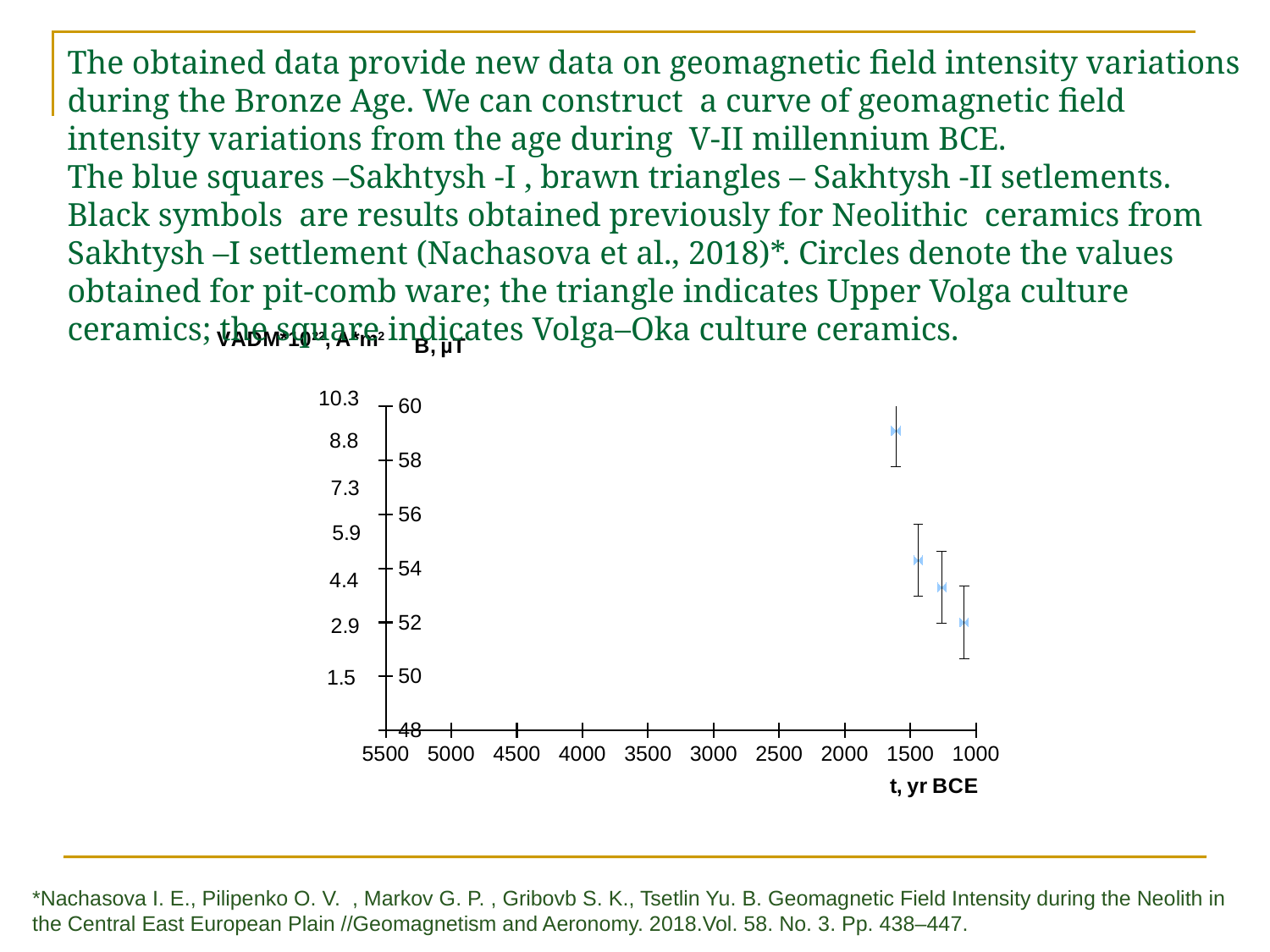
Is the value of the point plotted near 1250 BCE greater or less than 52 μT? greater What is the label of the right-hand vertical axis of the chart? B, μT Which of the two is larger: the B value of the point near 1600 BCE or the point near 1100 BCE? the point near 1600 BCE How many data points are plotted on the chart? 4 Is the value of the leftmost plotted point (near 1600 BCE) greater or less than 58 μT? greater Is the value of the rightmost plotted point (near 1100 BCE) greater or less than 54 μT? less Do the plotted B values rise or fall moving from left to right along the x axis? fall What is the highest value shown on the B, μT axis? 60 What kind of chart is shown on the slide? scatter chart What is the label of the x axis of the chart? t, yr BCE